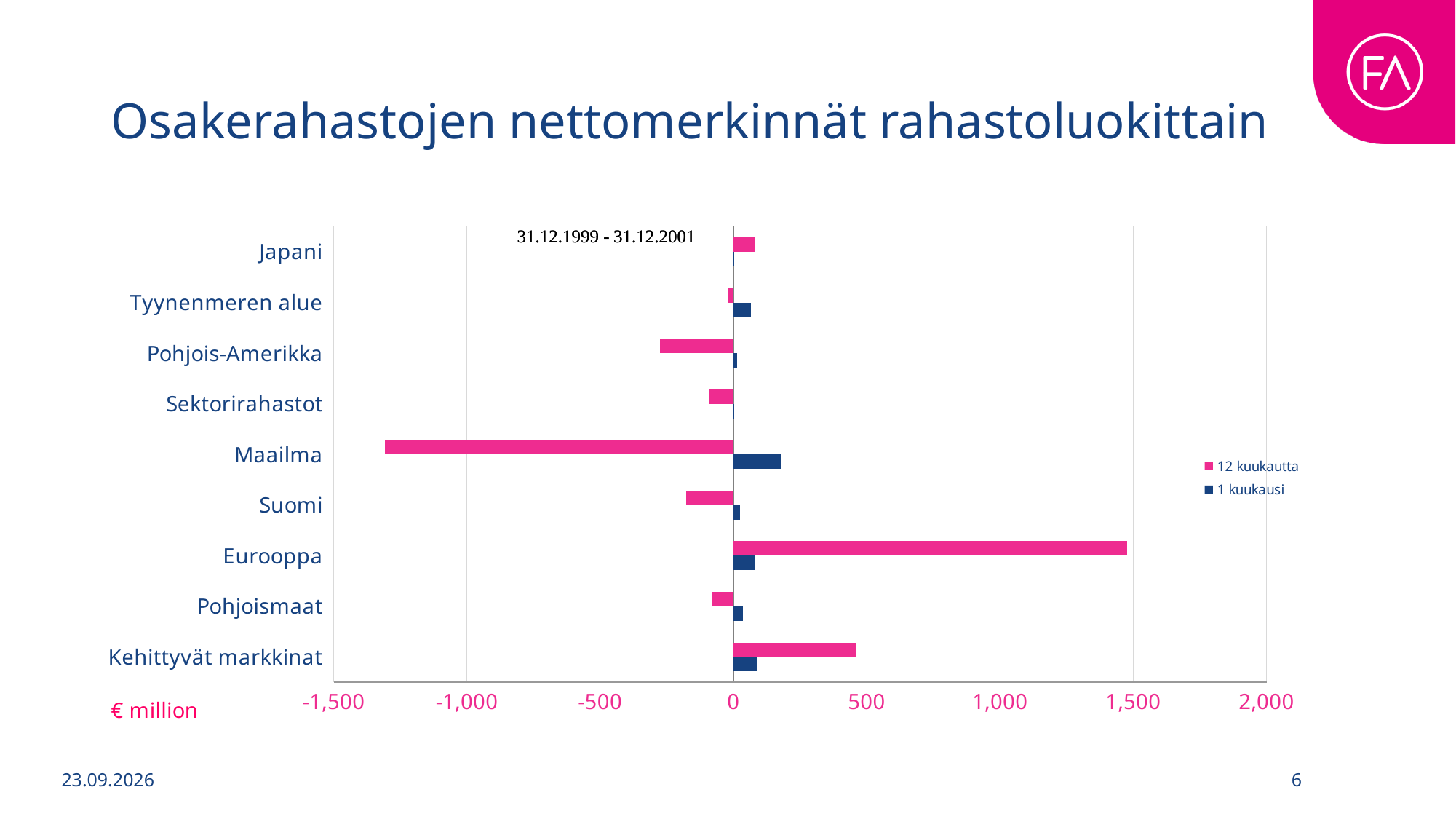
What unit is shown for the chart's horizontal axis? € million Is the 12 kuukautta value for Kehittyvät markkinat greater or less than 500? less What kind of chart is shown on the slide? bar chart Which category has the lowest 12 kuukautta value? Maailma How many fund categories are shown on the chart? 9 Is the 12 kuukautta value for Eurooppa greater or less than 1,000? greater Which is larger, the 12 kuukautta value for Eurooppa or for Kehittyvät markkinat? Eurooppa Is the 12 kuukautta value for Maailma greater or less than -1,000? less How many series does the chart legend list? 2 What is the title of the chart on the slide? Osakerahastojen nettomerkinnät rahastoluokittain Which category has the highest 12 kuukautta value? Eurooppa Which category has the highest 1 kuukausi value? Maailma